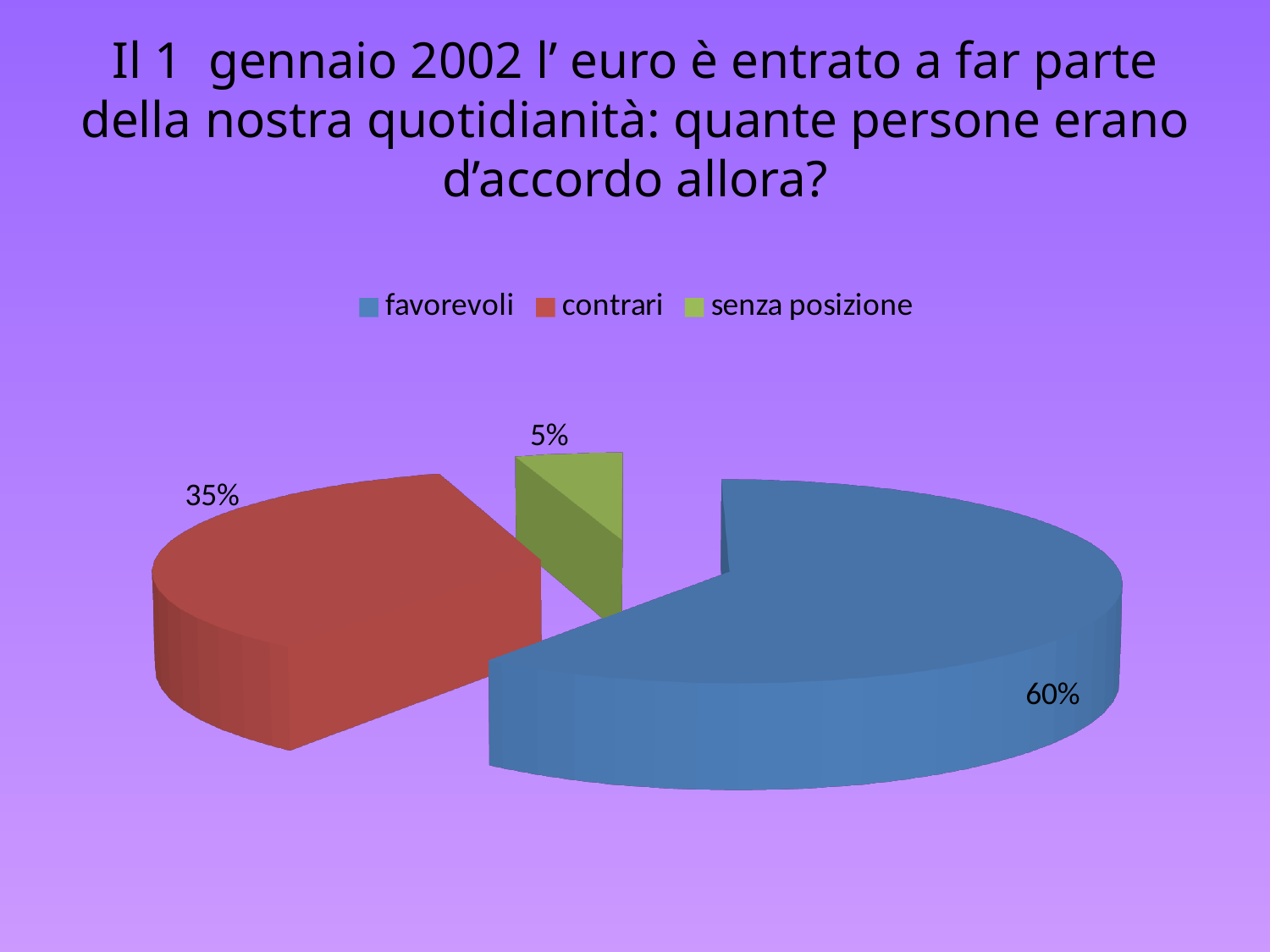
How many slices does the pie chart have? 3 What kind of chart is shown on the slide? pie chart What percentage of the pie is labelled for "senza posizione"? 5% Which is larger, the slice for "contrari" or the slice for "senza posizione"? contrari How many entries does the legend list? 3 What percentage of the pie is labelled for "favorevoli"? 60% What is the difference in percentage points between "favorevoli" and "contrari"? 25 What is the difference in percentage points between "contrari" and "senza posizione"? 30 Which category has the largest slice of the pie? favorevoli What colour is the slice for "contrari"? red What percentage of the pie is labelled for "contrari"? 35% Which category has the smallest slice of the pie? senza posizione